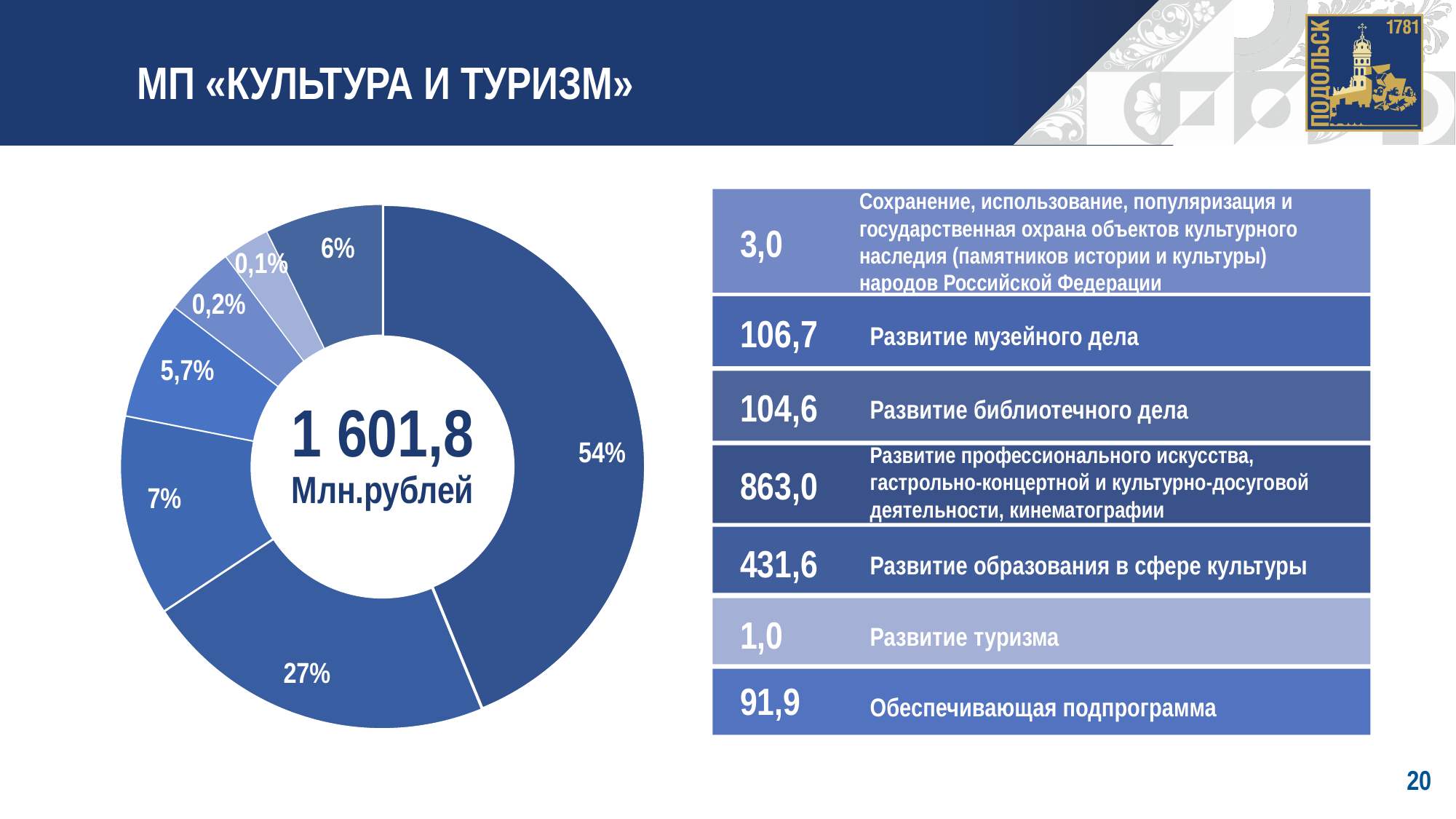
What is the total shown in the centre of the donut chart? 1 601,8 What unit is written in the centre of the donut chart? Млн.рублей What is the value listed for «Развитие образования в сфере культуры»? 431,6 What is the largest percentage labelled on the donut chart? 54% What is the value listed for «Развитие туризма»? 1,0 Which is larger: the value for «Развитие музейного дела» or for «Развитие библиотечного дела»? Развитие музейного дела What is the smallest percentage labelled on the donut chart? 0,1% How many slices does the donut chart have? 7 What is the difference between the values for «Развитие профессионального искусства, гастрольно-концертной и культурно-досуговой деятельности, кинематографии» (863,0) and «Развитие образования в сфере культуры» (431,6)? 431,4 Which subprogramme has the largest value in the list: «Развитие профессионального искусства, гастрольно-концертной и культурно-досуговой деятельности, кинематографии» or «Обеспечивающая подпрограмма»? Развитие профессионального искусства, гастрольно-концертной и культурно-досуговой деятельности, кинематографии What kind of chart is shown on the left of the slide? pie (donut) chart What is the value listed for «Развитие музейного дела»? 106,7